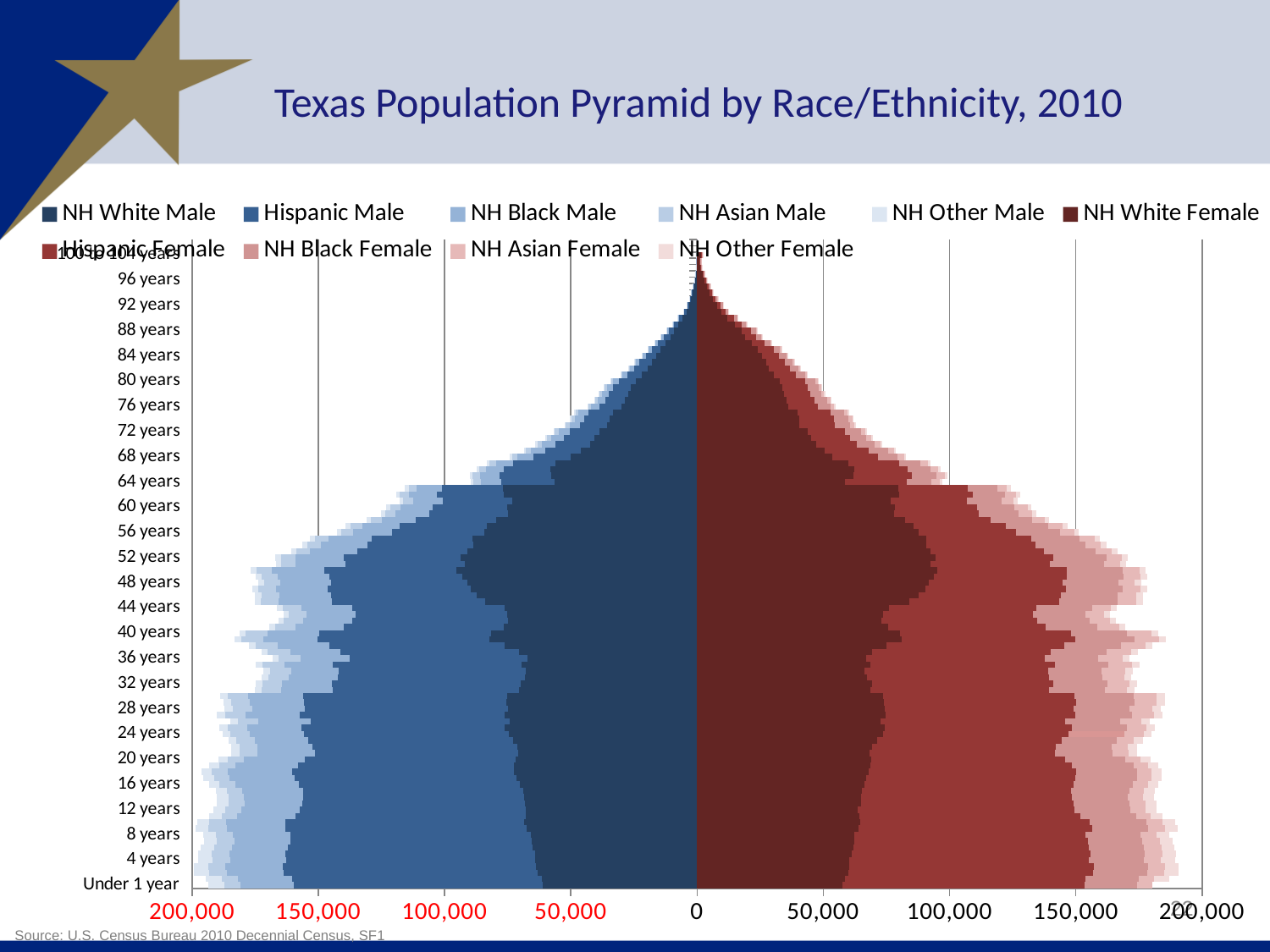
Is the total female population for 96 years greater or less than 50,000? less Is the total male population for 64 years greater or less than 100,000? less Which series makes up the largest part of the male bar for 64 years? NH White Male What kind of chart is shown on the slide? Bar chart (population pyramid) What is the title of the chart? Texas Population Pyramid by Race/Ethnicity, 2010 Is the total male population for Under 1 year greater or less than 150,000? greater Which age group has the longer total male bar, Under 1 year or 64 years? Under 1 year Moving from the youngest age groups at the bottom to the oldest at the top, do the total bar lengths generally rise or fall? fall How many series does the legend list? 10 Which series makes up the largest part of the male bar for Under 1 year? Hispanic Male Which series is listed first in the legend? NH White Male